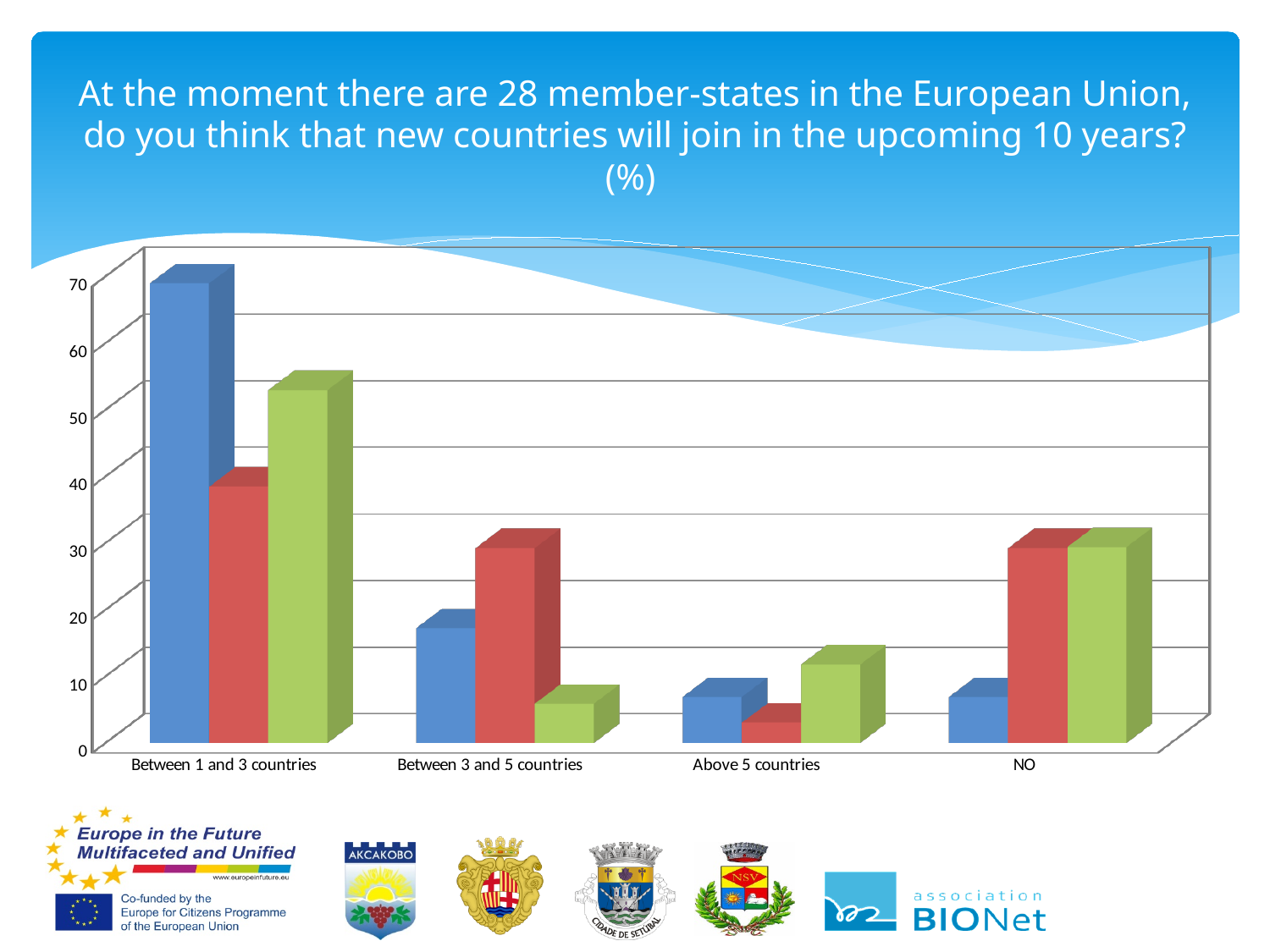
How many bars are plotted for each category in the chart? 3 Is the value of the green bar for "Above 5 countries" greater or less than 20? less What kind of chart is shown on the slide? bar chart Which category has the tallest blue bar? Between 1 and 3 countries Is the value of the green bar for "Between 3 and 5 countries" greater or less than 10? less How many categories are shown on the x axis of the chart? 4 For "Between 3 and 5 countries", which is taller, the blue bar or the red bar? the red bar Is the value of the red bar for "NO" greater or less than 20? greater Which category has the lowest red bar? Above 5 countries What is the highest value shown on the vertical axis of the chart? 70